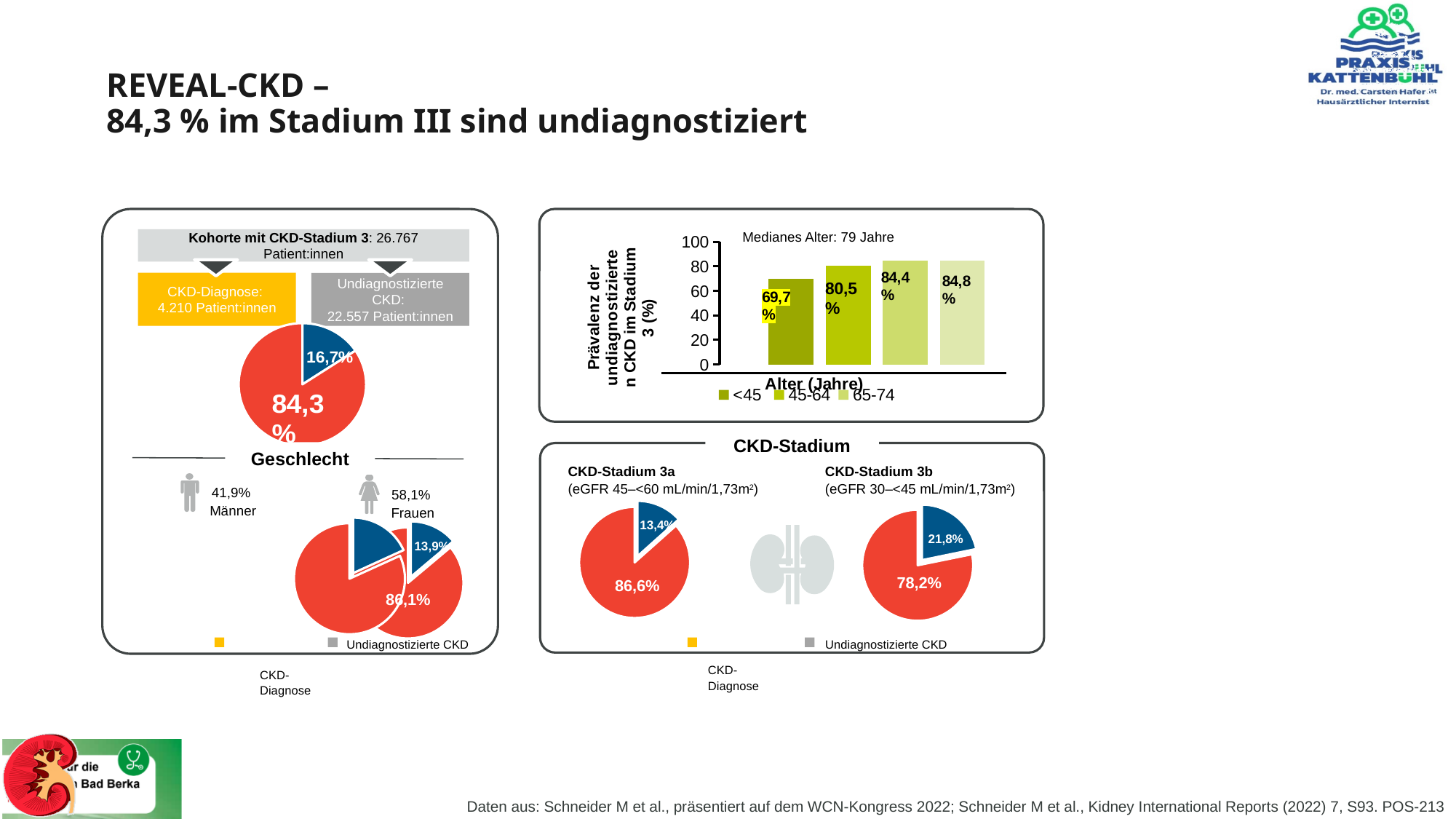
In the bar chart on the right, what is the value for the age group 65-74? 84,4 % What kind of chart is the chart showing prevalence by age group on the right? bar chart In the bar chart on the right, what is the difference between the values for 45-64 and <45? 10,8 percentage points In the bar chart on the right, what is the value for the age group <45? 69,7 % Which pie chart has the larger blue (CKD-Diagnose) slice, CKD-Stadium 3a or CKD-Stadium 3b? CKD-Stadium 3b In the bar chart on the right, which of the age groups <45 and 45-64 has the higher value? 45-64 In the bar chart on the right, do the values rise or fall from left to right across the age groups? rise In the bar chart on the right, what is the value for the age group 45-64? 80,5 % How many entries does the legend of the bar chart on the right list? 3 In the bar chart on the right, is the value for the age group <45 greater or less than 80? less In the CKD-Stadium 3a pie chart, what share is labelled as undiagnosed CKD? 86,6% In the CKD-Stadium 3b pie chart, what share is labelled as CKD-Diagnose (the blue slice)? 21,8%